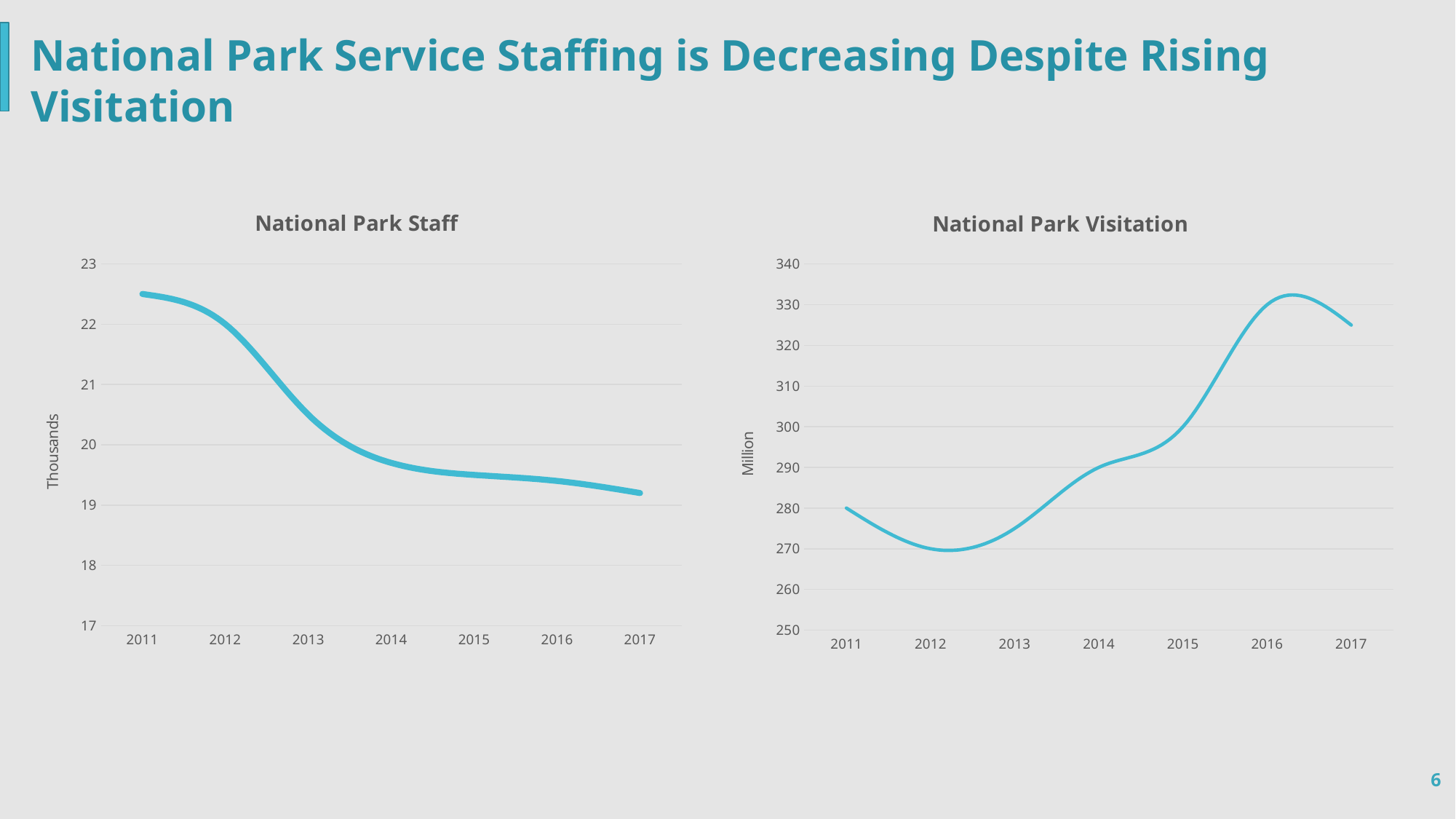
In the National Park Visitation chart, which is larger, the value for 2016 or the value for 2017? 2016 In the National Park Staff chart, do the values rise or fall from 2011 to 2017? fall In the National Park Staff chart, how many years are shown on the x axis? 7 In the National Park Staff chart, which year has the lowest value? 2017 In the National Park Visitation chart, which year has the lowest value? 2012 In the National Park Staff chart, is the value for 2011 greater or less than 22? greater In the National Park Staff chart, which year has the highest value? 2011 In the National Park Visitation chart, how many years are shown on the x axis? 7 In the National Park Visitation chart, is the value for 2016 greater or less than 320? greater What kind of chart is the National Park Staff chart? line chart In the National Park Visitation chart, do the values rise or fall from 2012 to 2016? rise What kind of chart is the National Park Visitation chart? line chart